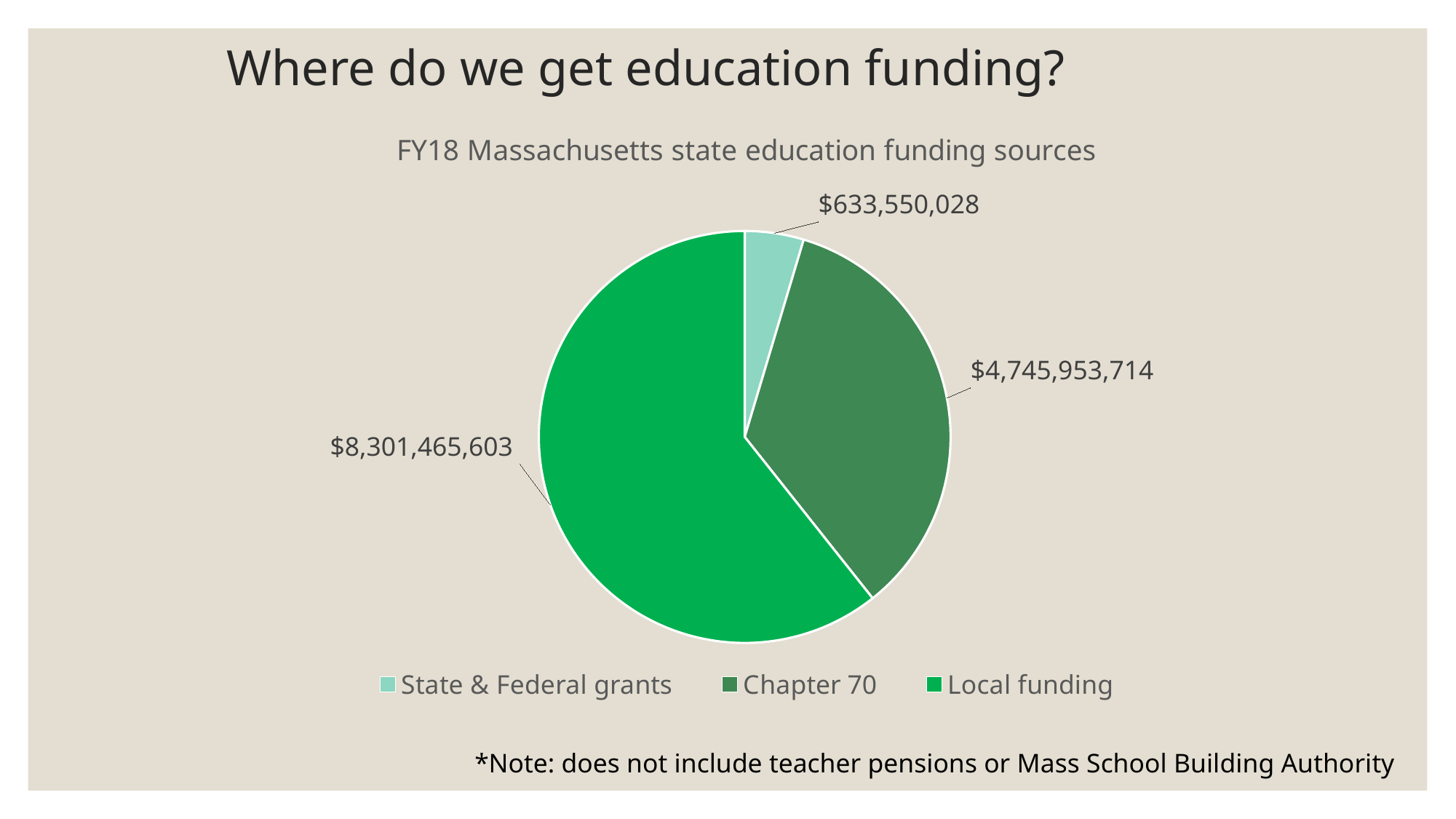
What is the title of the chart? FY18 Massachusetts state education funding sources What is the value for Chapter 70? $4,745,953,714 Which funding source is the largest? Local funding Which legend entry is shown in the lightest green colour? State & Federal grants What is the value for State & Federal grants? $633,550,028 Which is larger, Chapter 70 or State & Federal grants? Chapter 70 What is the difference between Local funding and Chapter 70? $3,555,511,889 Which funding source is the smallest? State & Federal grants What is the total of all three funding sources shown? $13,680,969,345 What type of chart is shown on the slide? Pie chart How many funding sources does the pie chart show? 3 What is the value for Local funding? $8,301,465,603